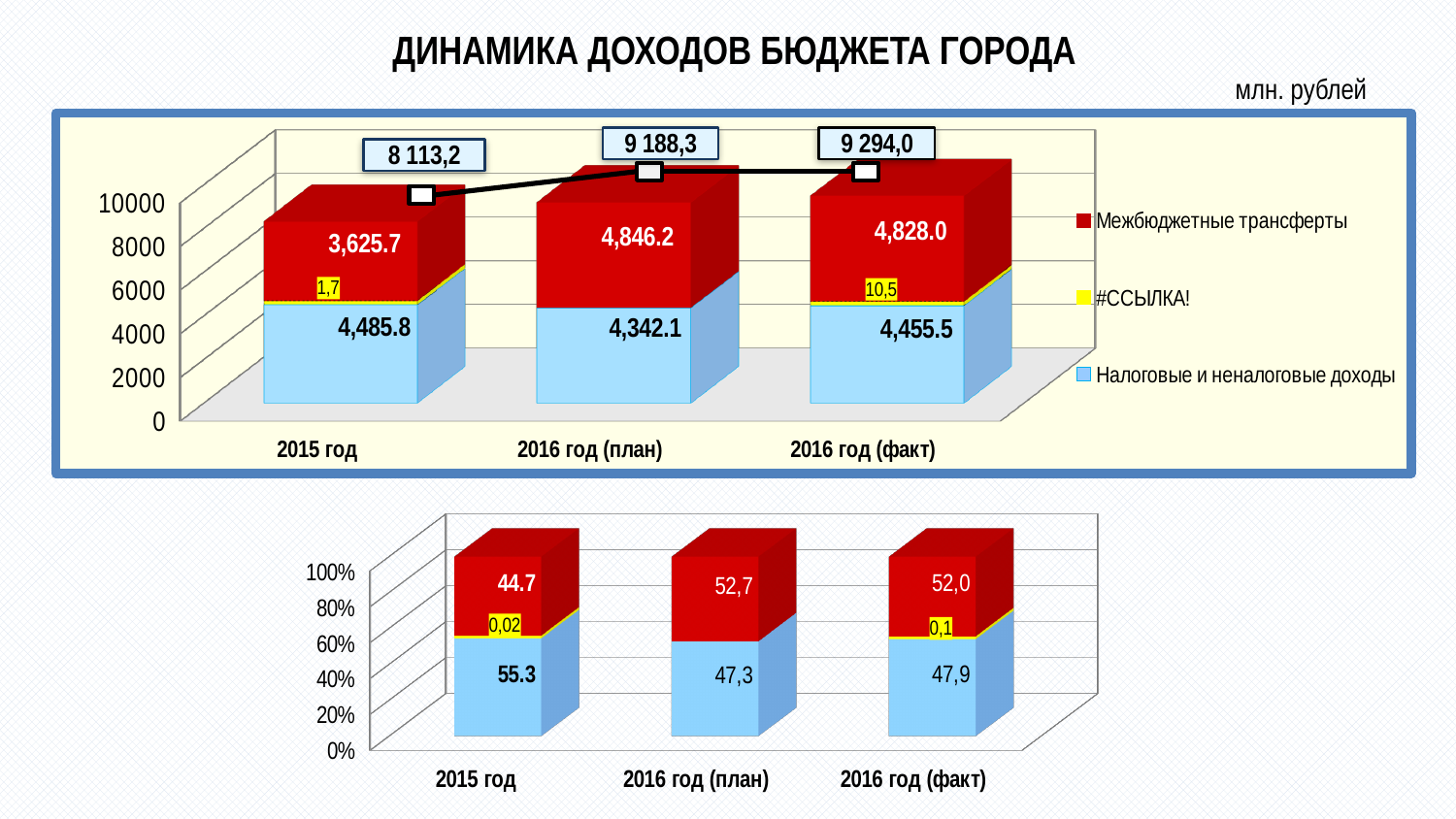
In the top chart, how many categories are shown on the x axis? 3 In the bottom chart, what is the value of the red segment (Межбюджетные трансферты) for 2015 год? 44.7 In the top chart, how many series does the legend list? 3 In the top chart, what is the value of Налоговые и неналоговые доходы for 2015 год? 4,485.8 In the top chart, what total is shown on the line for 2016 год (факт)? 9 294,0 In the bottom chart, what is the value of the blue segment (Налоговые и неналоговые доходы) for 2016 год (план)? 47,3 In the top chart, do the totals shown on the line rise or fall from 2015 год to 2016 год (факт)? rise In the top chart, which category has the highest total shown on the line? 2016 год (факт) In the top chart, which is larger: Налоговые и неналоговые доходы for 2015 год or for 2016 год (факт)? 2015 год What kind of chart is the bottom chart? bar chart In the top chart, what is the value of Межбюджетные трансферты for 2016 год (план)? 4,846.2 In the top chart, what is the difference between Межбюджетные трансферты for 2016 год (план) and 2016 год (факт)? 18.2